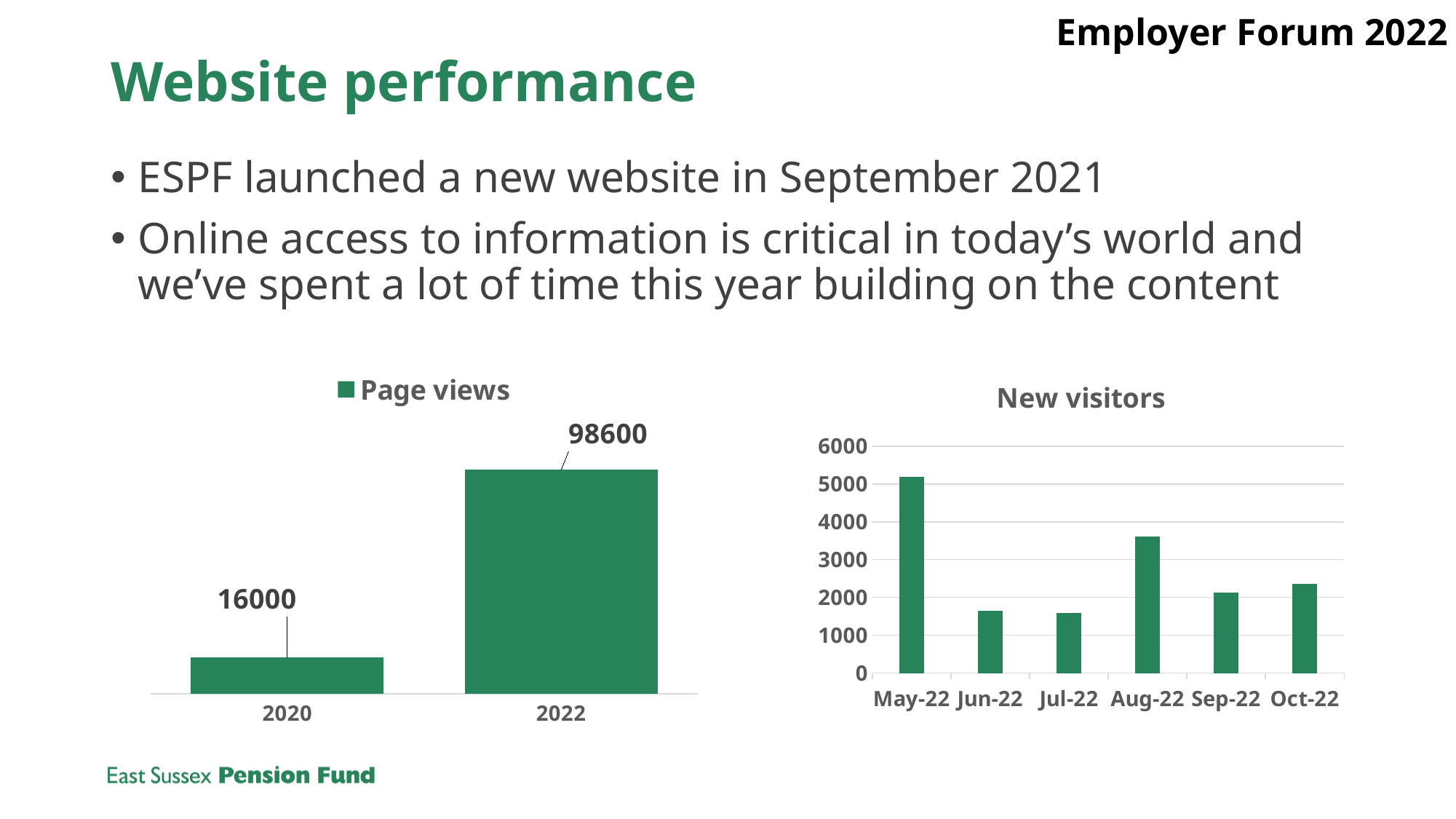
In the Page views chart, what is the value for 2022? 98600 In the Page views chart, what is the value for 2020? 16000 In the Page views chart, what is the difference between the 2022 and 2020 values? 82600 In the Page views chart, which year has the higher value? 2022 In the New visitors chart, is the value for Jun-22 greater or less than 2000? less In the New visitors chart, is the value for May-22 greater or less than 5000? greater How many categories are shown in the Page views chart? 2 What kind of chart is the New visitors chart? bar chart In the New visitors chart, which month has the highest value? May-22 How many months are shown in the New visitors chart? 6 In the New visitors chart, is the value for Aug-22 greater or less than 3000? greater